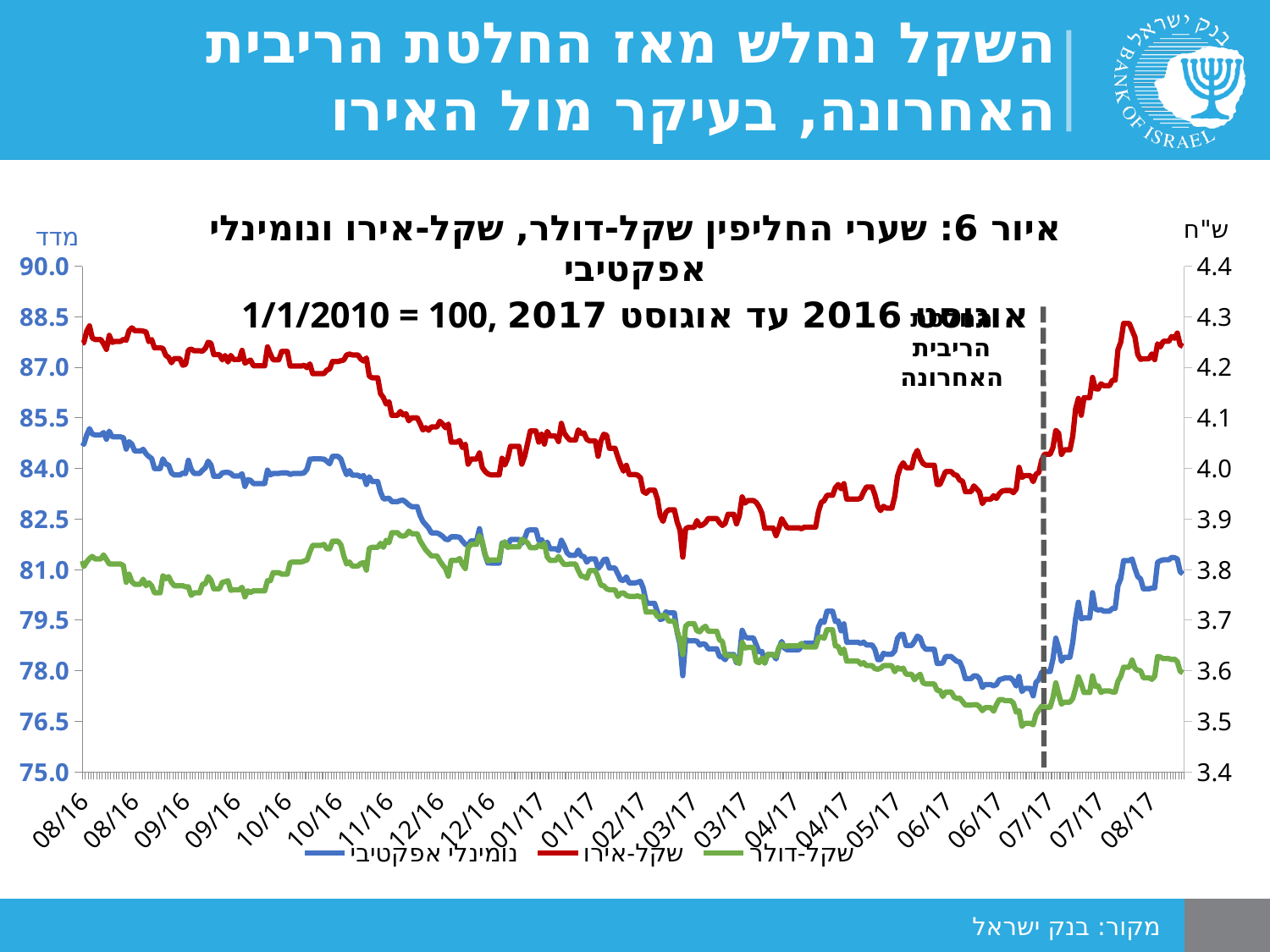
Is the lowest point of the שקל-דולר series (around 06/17) greater or less than 3.6 on the right axis? less At the end of the period (08/17), which series is higher on the right axis: שקל-אירו or שקל-דולר? שקל-אירו Does the שקל-אירו series rise or fall between the dashed line (07/17) and the end of the period (08/17)? rise Is the value of the נומינלי אפקטיבי series at the start of the period (08/16) greater or less than 84.0 on the left axis? greater What kind of chart is shown on the slide? Line chart Is the value of the שקל-אירו series at the start of the period (08/16) greater or less than 4.2 on the right axis? greater How many series does the legend list? 3 What does the label next to the dashed vertical line say? החלטת הריבית האחרונה Which series are listed in the legend? נומינלי אפקטיבי, שקל-אירו, שקל-דולר